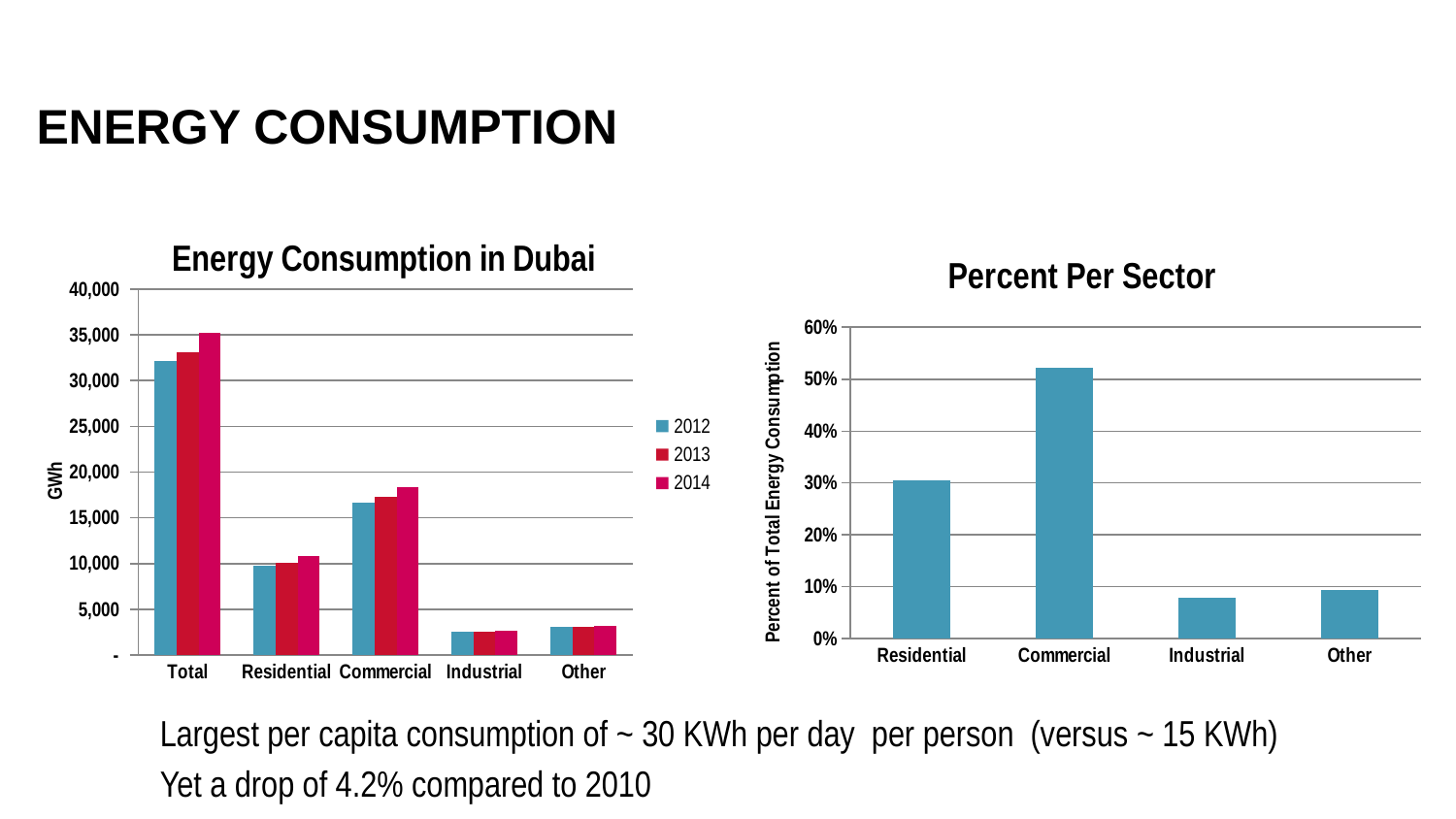
In the 'Energy Consumption in Dubai' chart, what unit is shown on the y axis? GWh In the 'Energy Consumption in Dubai' chart, which is larger for 2013: Commercial or Residential? Commercial In the 'Energy Consumption in Dubai' chart, which category has the lowest values? Industrial In the 'Percent Per Sector' chart, which sector has the lowest percentage? Industrial In the 'Energy Consumption in Dubai' chart, is the 2014 value for Total greater or less than 30,000? greater In the 'Energy Consumption in Dubai' chart, is the 2012 value for Industrial greater or less than 5,000? less In the 'Percent Per Sector' chart, which sector has the highest percentage? Commercial What kind of chart is 'Energy Consumption in Dubai'? bar chart In the 'Energy Consumption in Dubai' chart, how many categories are shown on the x axis? 5 In the 'Energy Consumption in Dubai' chart, do the Total values rise or fall from 2012 to 2014? rise In the 'Percent Per Sector' chart, is the value for Residential greater or less than 20%? greater In the 'Energy Consumption in Dubai' chart, how many series does the legend list? 3